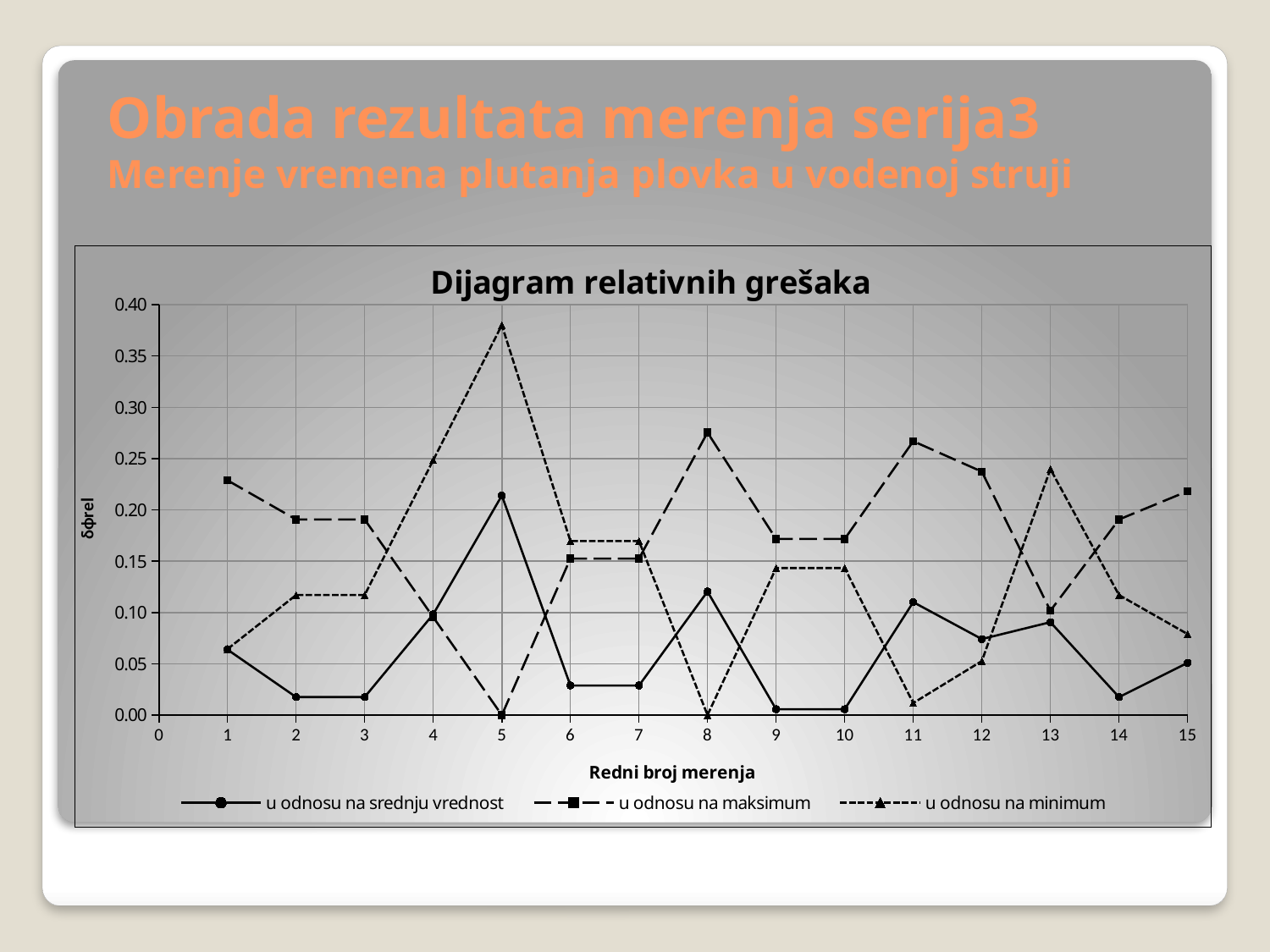
At which measurement does the 'u odnosu na srednju vrednost' series reach its highest value? 5 What kind of chart is shown on the slide? line chart At which measurement does the 'u odnosu na maksimum' series reach its lowest value? 5 How many measurements (data points per series) are plotted on the chart? 15 What is the label of the x axis? Redni broj merenja How many series does the legend list? 3 At which measurement does the 'u odnosu na minimum' series reach its highest value? 5 What is the title of the chart? Dijagram relativnih grešaka Is the value of the 'u odnosu na minimum' series at measurement 5 greater or less than 0.35? greater What is the value of the 'u odnosu na minimum' series at measurement 8? 0.00 What is the value of the 'u odnosu na maksimum' series at measurement 5? 0.00 At measurement 1, which series has the larger value: 'u odnosu na maksimum' or 'u odnosu na srednju vrednost'? u odnosu na maksimum